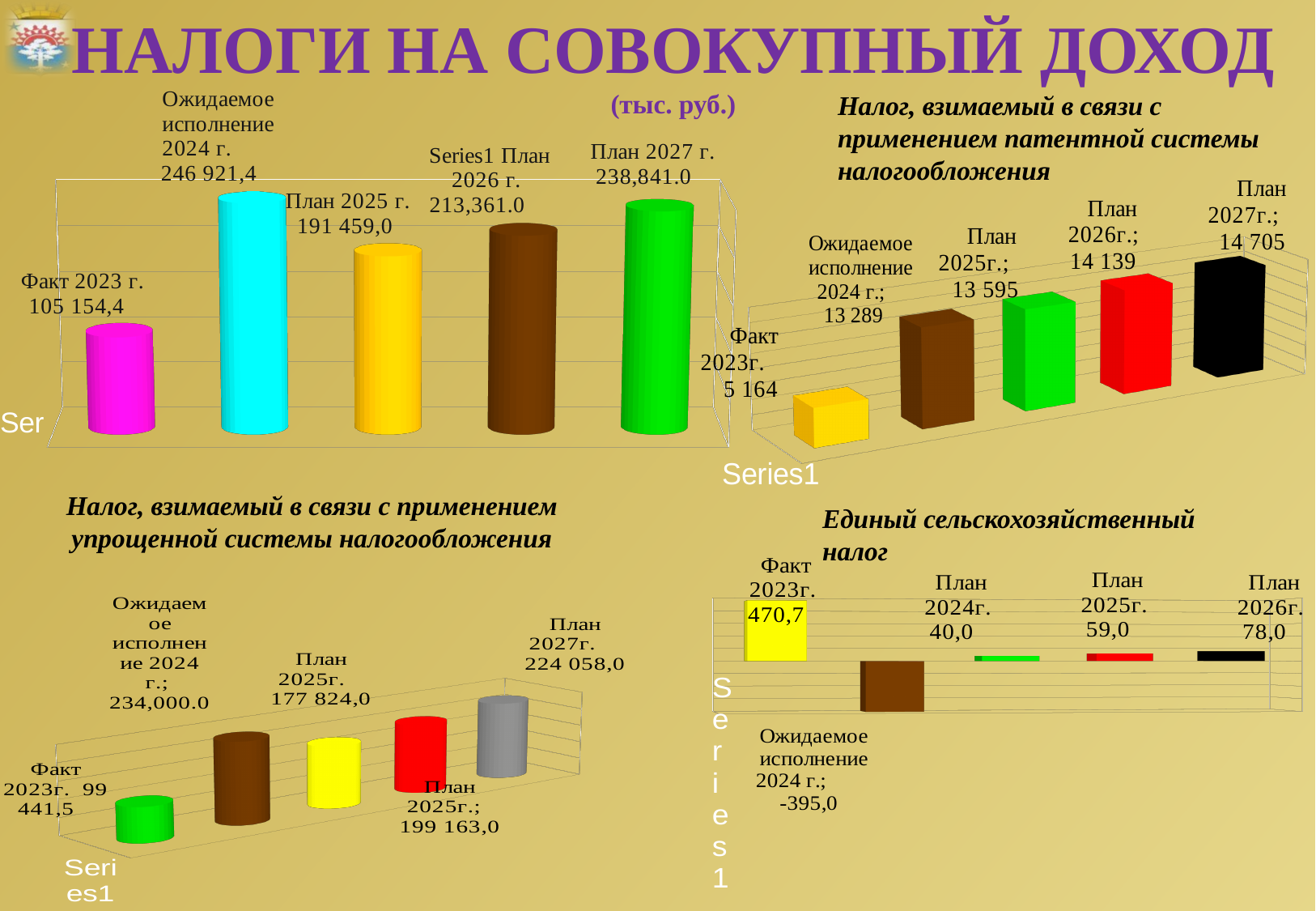
In the top-left chart (Налоги на совокупный доход), what is the value for Факт 2023 г.? 105 154,4 In the top-right chart (патентной системы налогообложения), do the values rise or fall from left to right? rise In the bottom-right chart (Единый сельскохозяйственный налог), which category has the highest value? Факт 2023г. In the top-right chart (патентной системы налогообложения), what is the value for План 2027г.? 14 705 In the bottom-right chart (Единый сельскохозяйственный налог), what is the value for Ожидаемое исполнение 2024 г.? -395,0 What type of chart is the top-left chart (Налоги на совокупный доход)? bar chart In the top-right chart (патентной системы налогообложения), which category has the lowest value? Факт 2023г. In the top-left chart (Налоги на совокупный доход), how many bars are plotted? 5 In the top-right chart (патентной системы налогообложения), what is the difference between План 2027г. and План 2026г.? 566 In the bottom-left chart (упрощенной системы налогообложения), which is larger: Ожидаемое исполнение 2024 г. or План 2027г.? Ожидаемое исполнение 2024 г. In the bottom-left chart (упрощенной системы налогообложения), what is the value for План 2027г.? 224 058,0 In the top-left chart (Налоги на совокупный доход), which category has the highest value? Ожидаемое исполнение 2024 г.